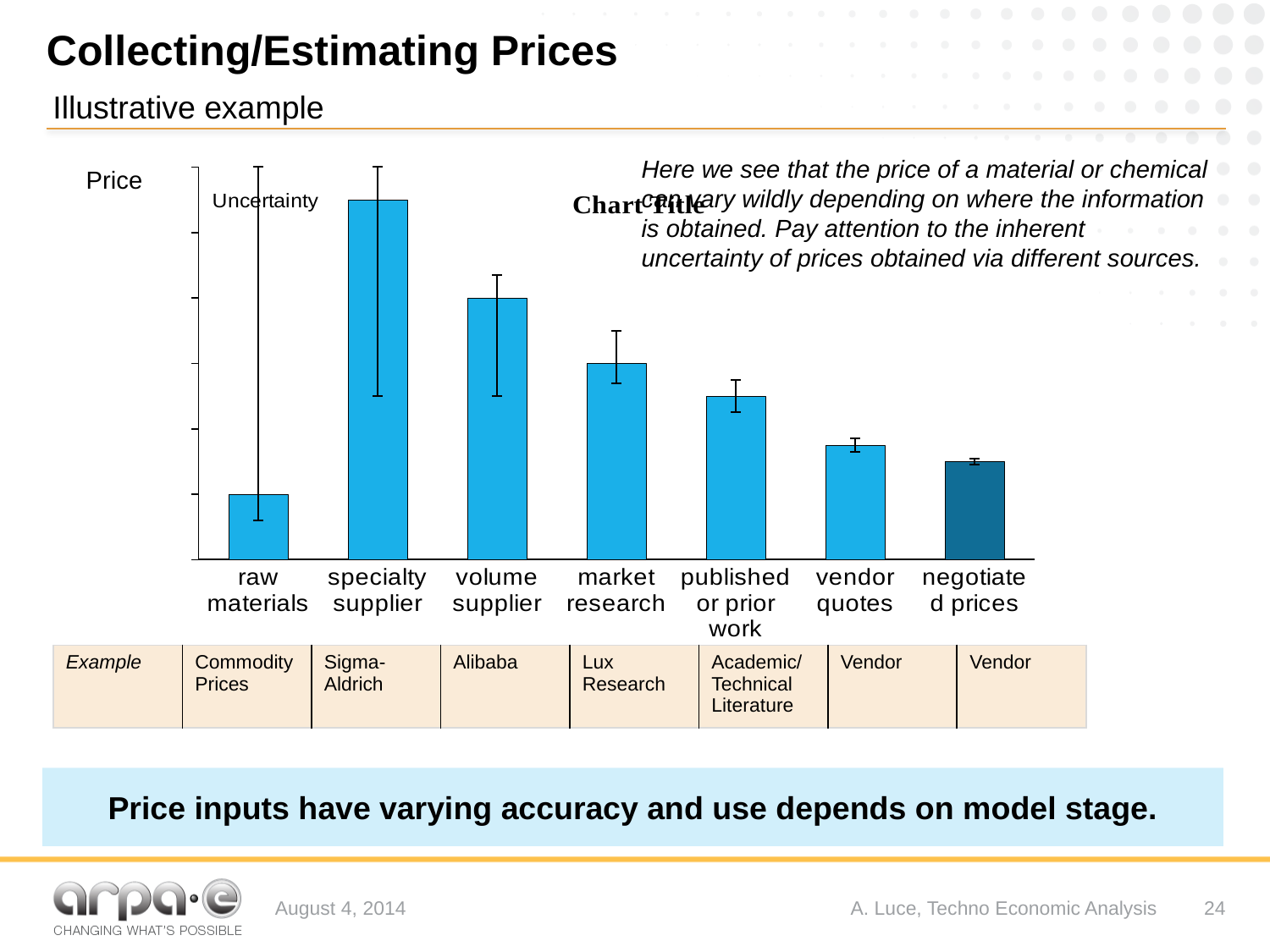
Moving from specialty supplier to negotiated prices along the x axis, do the bars rise or fall? fall What is the label on the vertical axis of the chart? Price How many categories are shown on the x axis of the chart? 7 Which category has the lowest bar in the chart? raw materials Which bar is taller, volume supplier or market research? volume supplier Which bar is taller, published or prior work or vendor quotes? published or prior work Which bar is taller, specialty supplier or volume supplier? specialty supplier What kind of chart is shown on the slide? bar chart Which category has the highest bar in the chart? specialty supplier Which category's bar is drawn in a darker shade of blue than the others? negotiated prices